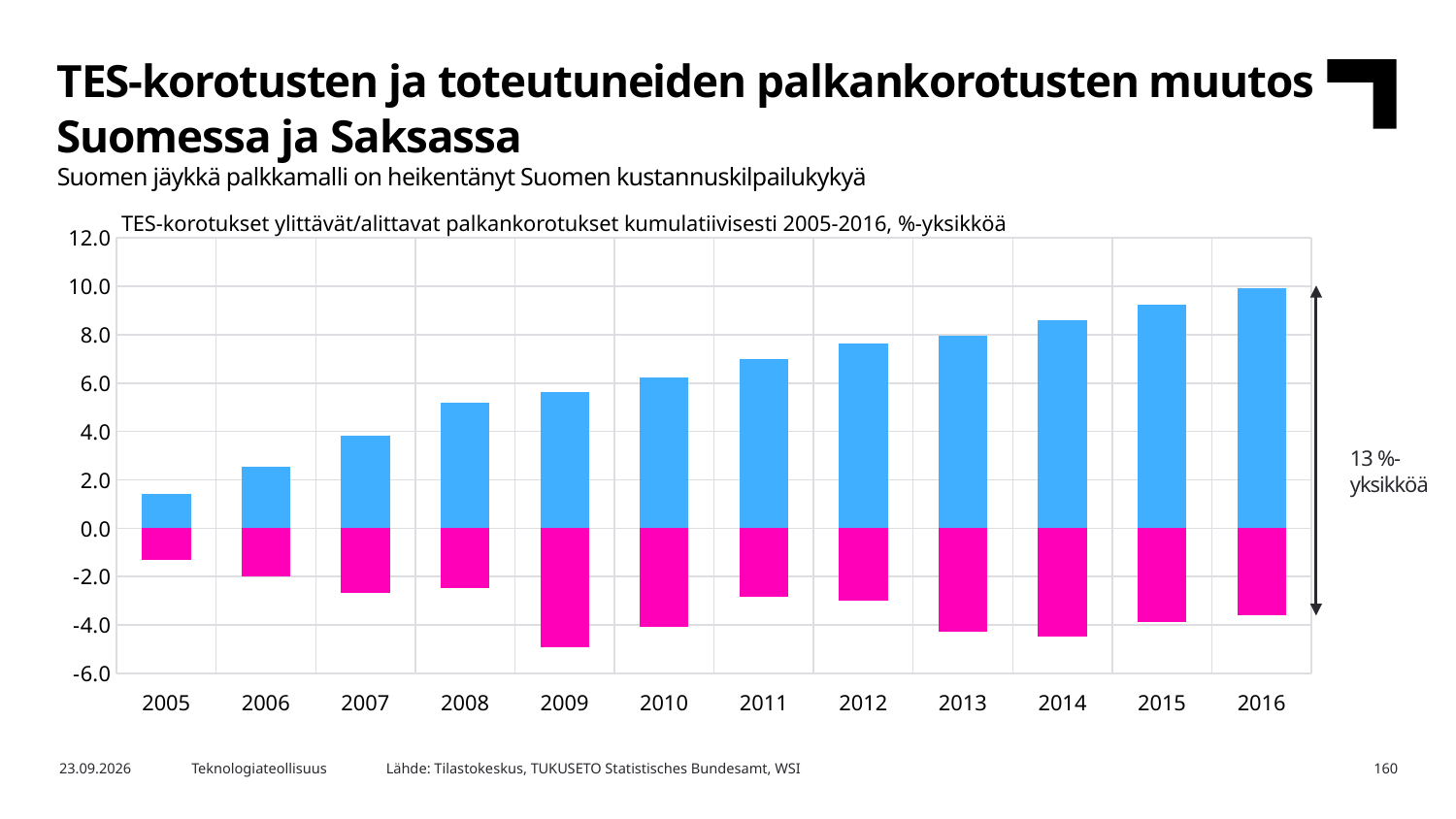
Which year has the lowest (most negative) magenta bar? 2009 Do the blue bars rise or fall from 2005 to 2016? rise Is the blue bar for 2005 greater or less than 2.0? less Is the blue bar for 2016 greater or less than 8.0? greater What kind of chart is shown on the slide? bar chart Which year has the shortest blue (positive) bar? 2005 Is the blue bar for 2011 greater or less than 6.0? greater Which year has the larger blue bar, 2007 or 2012? 2012 Which year has the tallest blue (positive) bar? 2016 How many years are shown on the x axis of the chart? 12 What value does the annotation with the double-headed arrow on the right of the chart state? 13 %-yksikköä